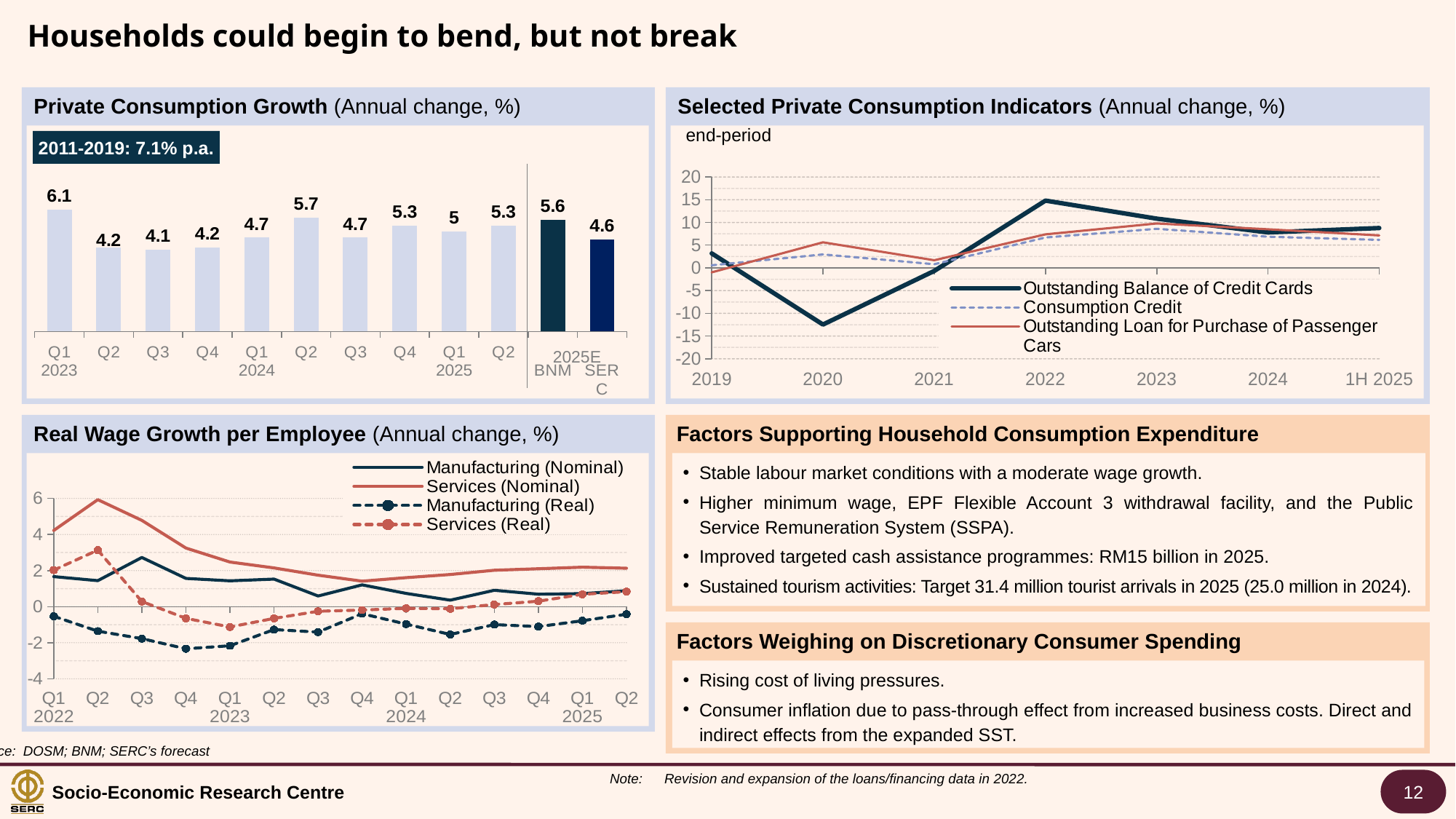
In the Private Consumption Growth chart, what average annual growth is shown for 2011-2019? 7.1% p.a. In the Private Consumption Growth chart, what is the SERC forecast for 2025E? 4.6 In the Private Consumption Growth chart, what is the value for Q1 2023? 6.1 How many series does the legend of the Selected Private Consumption Indicators chart list? 3 In the Private Consumption Growth chart, which quarter has the highest value? Q1 2023 What kind of chart is the Private Consumption Growth chart? bar chart In the Private Consumption Growth chart, how many bars are plotted? 12 How many series does the legend of the Real Wage Growth per Employee chart list? 4 In the Selected Private Consumption Indicators chart, is the value for Outstanding Balance of Credit Cards in 2020 greater or less than -10? less In the Private Consumption Growth chart, which quarter has the lowest value? Q3 2023 In the Private Consumption Growth chart, what is the difference between the BNM and SERC forecasts for 2025E? 1 In the Private Consumption Growth chart, which is larger: Q2 2024 or Q4 2024? Q2 2024